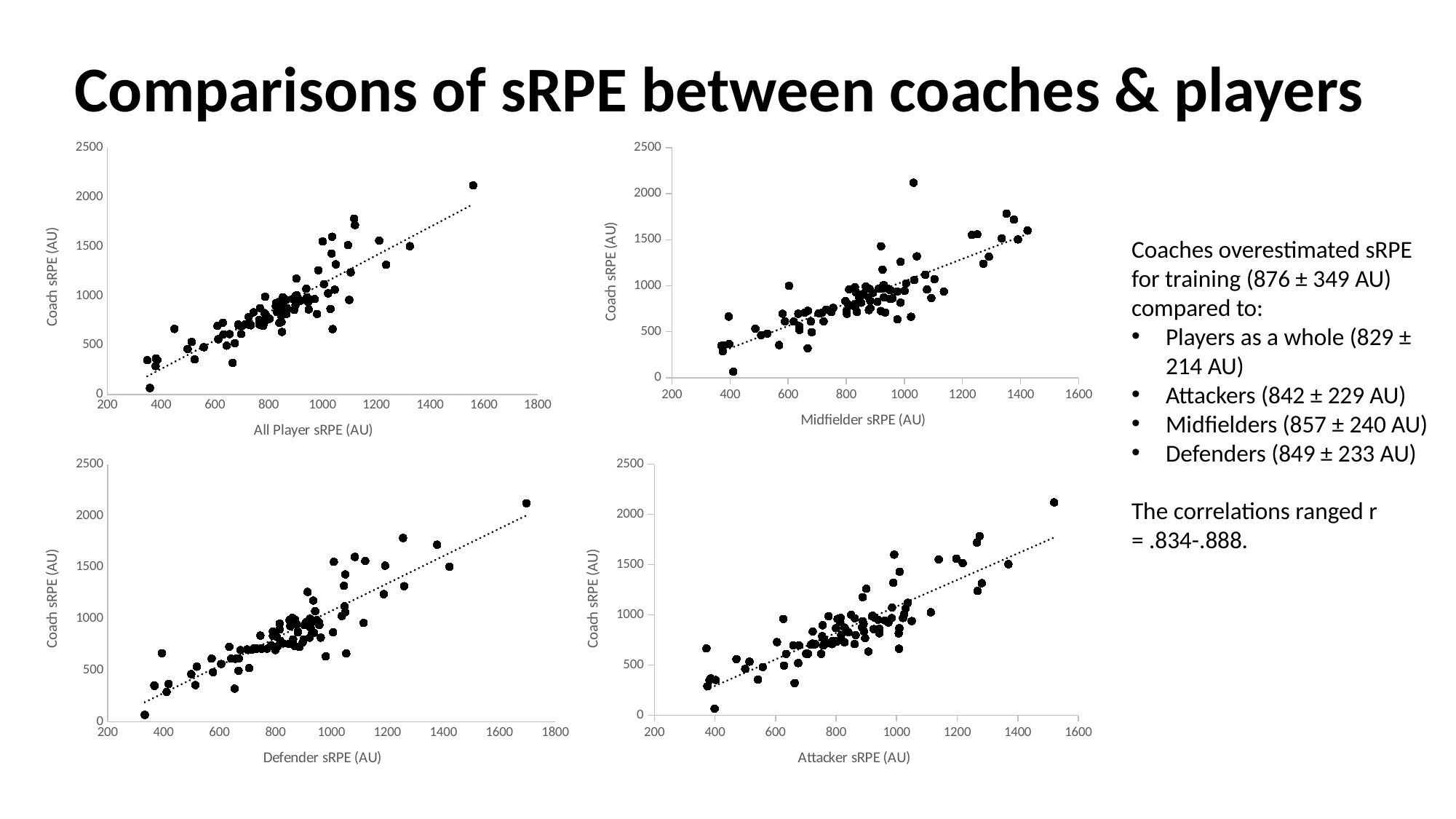
In the top-left chart (All Player sRPE), do the Coach sRPE values generally rise or fall as All Player sRPE increases along the x axis? rise What is the label of the y axis on the bottom-right chart? Coach sRPE (AU) In the top-left chart (All Player sRPE), is the highest Coach sRPE value plotted greater or less than 2000? greater What is the highest tick value shown on the y axis of the top-left chart (All Player sRPE)? 2500 In the top-right chart (Midfielder sRPE), is the highest Coach sRPE value plotted greater or less than 2000? greater In the bottom-right chart (Attacker sRPE), is the highest Coach sRPE value plotted greater or less than 2000? greater What is the label of the x axis on the bottom-left chart? Defender sRPE (AU) What kind of chart is the top-left chart with the x axis labelled All Player sRPE (AU)? scatter chart What is the highest tick value shown on the x axis of the top-right chart (Midfielder sRPE)? 1600 How many scatter charts are shown on the slide? 4 In the top-right chart (Midfielder sRPE), do the Coach sRPE values generally rise or fall as Midfielder sRPE increases? rise